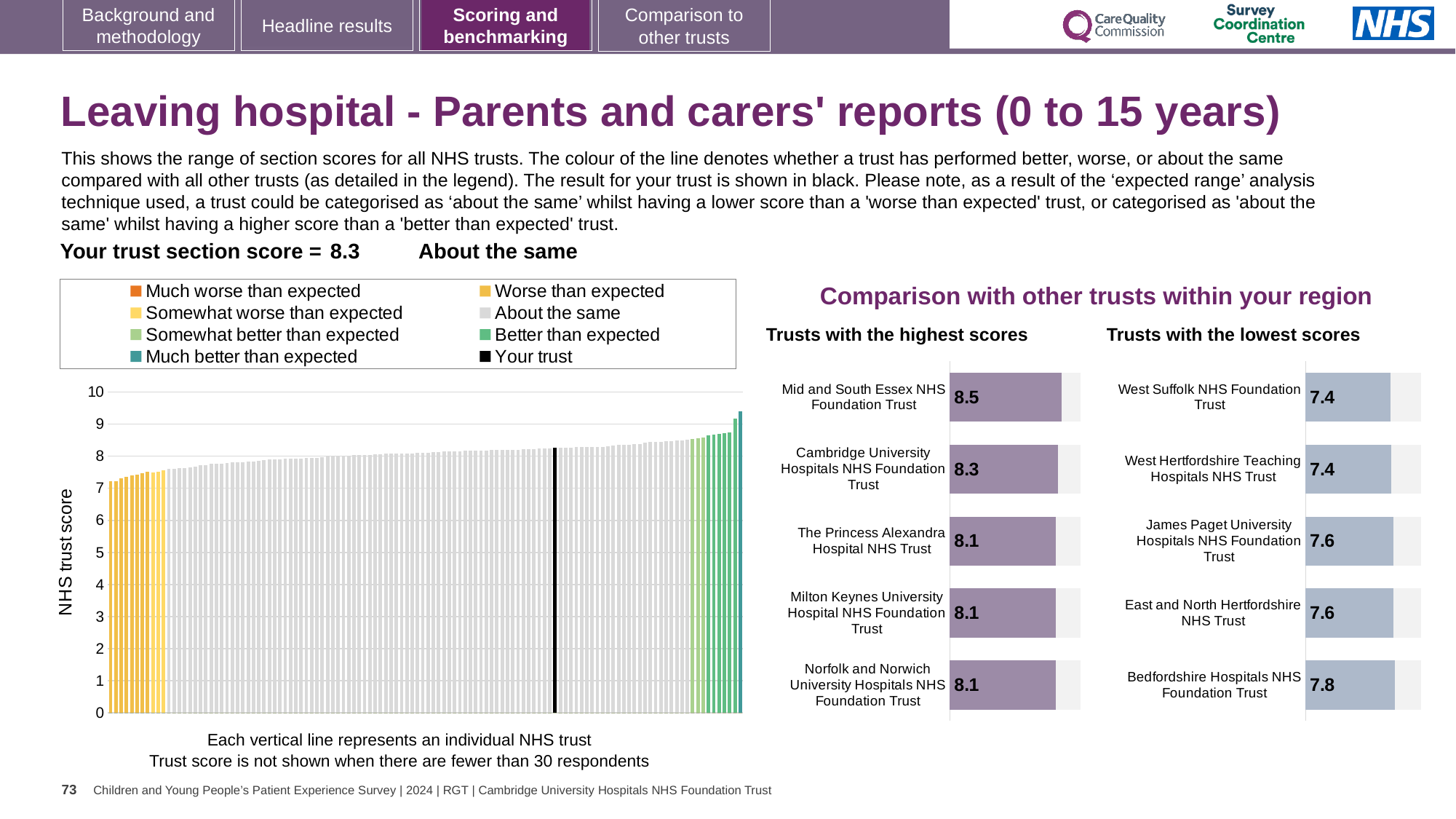
In the 'Trusts with the highest scores' chart, which trust has the highest score? Mid and South Essex NHS Foundation Trust In the 'Trusts with the highest scores' chart, what is the score for Mid and South Essex NHS Foundation Trust? 8.5 In the 'Trusts with the lowest scores' chart, what is the score for Bedfordshire Hospitals NHS Foundation Trust? 7.8 In the 'Trusts with the lowest scores' chart, what is the score for James Paget University Hospitals NHS Foundation Trust? 7.6 In the NHS trust score chart on the left, do the trust scores rise or fall from left to right along the x axis? Rise In the 'Trusts with the highest scores' chart, what is the score for Cambridge University Hospitals NHS Foundation Trust? 8.3 In the 'Trusts with the lowest scores' chart, which has the larger score: West Suffolk NHS Foundation Trust or Bedfordshire Hospitals NHS Foundation Trust? Bedfordshire Hospitals NHS Foundation Trust How many trusts are listed in the 'Trusts with the lowest scores' chart? 5 In the 'Trusts with the highest scores' chart, what is the difference between the scores of Mid and South Essex NHS Foundation Trust and Norfolk and Norwich University Hospitals NHS Foundation Trust? 0.4 What kind of chart is the NHS trust score chart on the left of the slide? Bar chart In the 'Trusts with the lowest scores' chart, which trust has the highest score shown? Bedfordshire Hospitals NHS Foundation Trust How many entries does the legend of the NHS trust score chart on the left list? 8